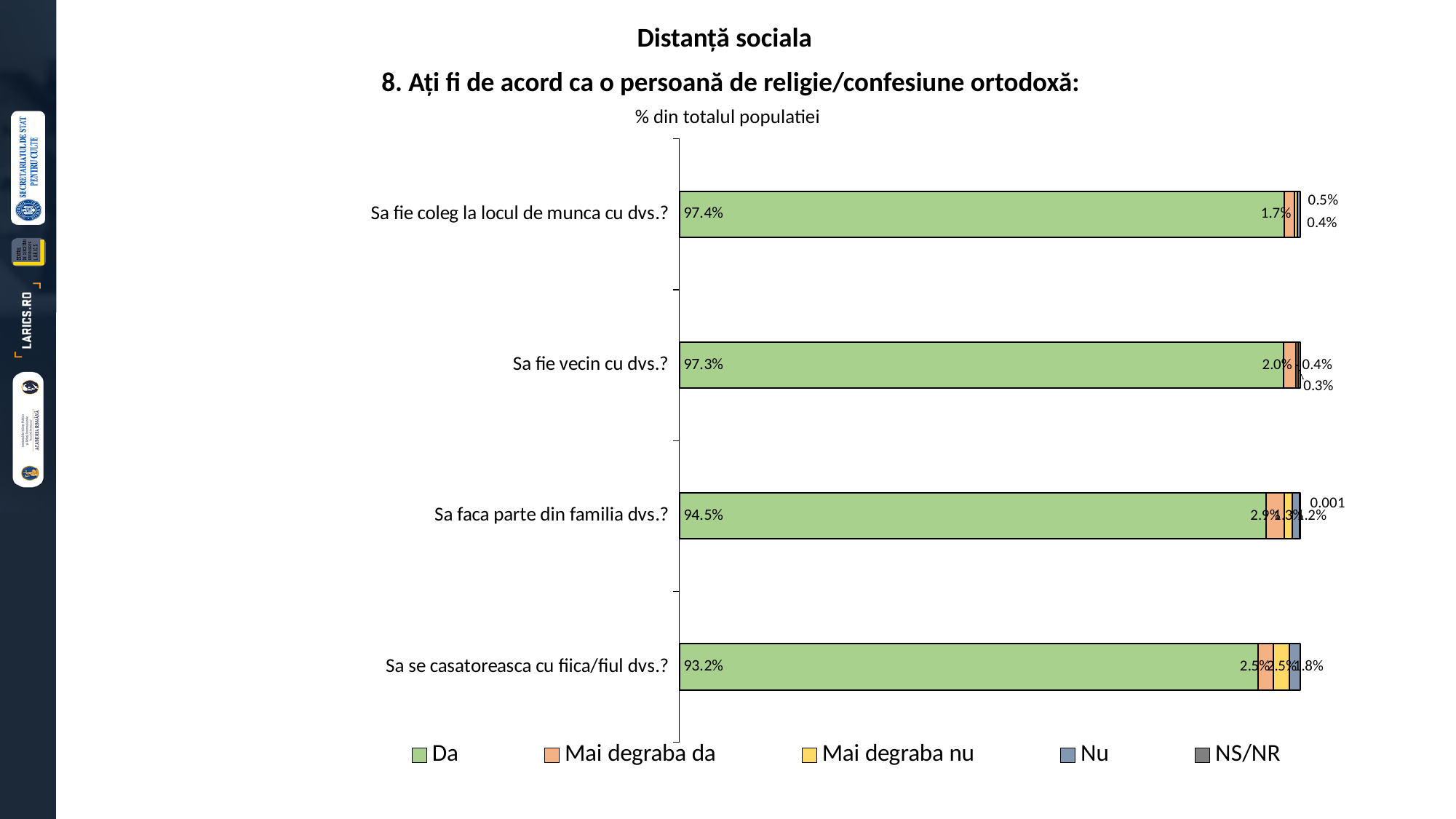
What is the "Mai degraba da" value for "Sa faca parte din familia dvs.?"? 2.9% What is the "Mai degraba da" value for "Sa fie vecin cu dvs.?"? 2.0% What is the first entry in the chart's legend? Da Which category has the highest "Da" value? Sa fie coleg la locul de munca cu dvs.? Which has a larger "Da" value: "Sa fie vecin cu dvs.?" or "Sa faca parte din familia dvs.?"? Sa fie vecin cu dvs.? What is the "Da" value for "Sa se casatoreasca cu fiica/fiul dvs.?"? 93.2% How many categories (questions) are shown in the chart? 4 What is the difference between the "Da" values for "Sa fie coleg la locul de munca cu dvs.?" and "Sa se casatoreasca cu fiica/fiul dvs.?"? 4.2 percentage points How many series does the legend list? 5 Which category has the lowest "Da" value? Sa se casatoreasca cu fiica/fiul dvs.? What is the "Da" value for "Sa fie coleg la locul de munca cu dvs.?"? 97.4% What kind of chart is shown on the slide? Stacked bar chart